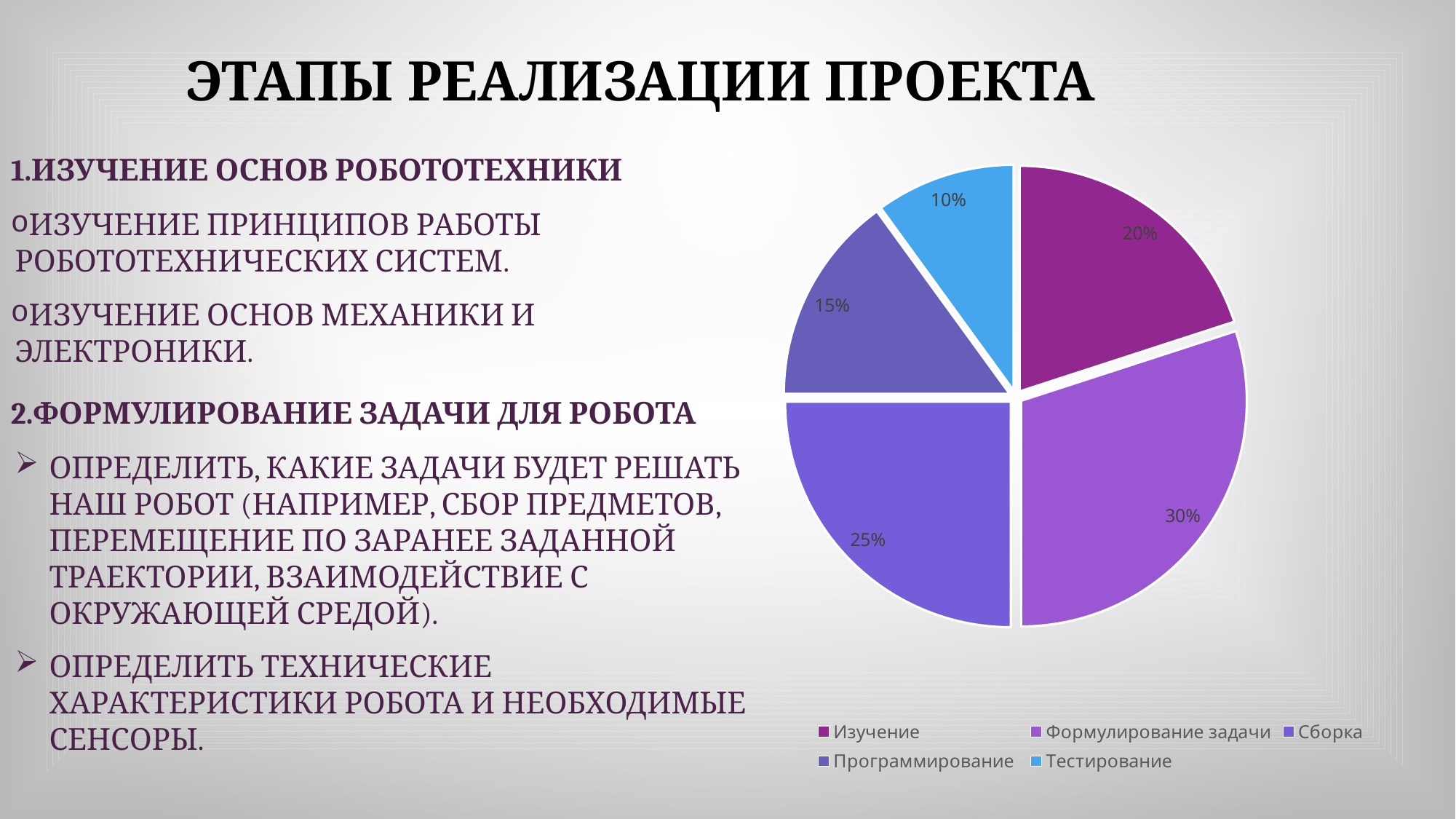
What share of the pie does Формулирование задачи have? 30% What is the difference between the shares of Формулирование задачи and Сборка? 5% Which category has the largest slice of the pie? Формулирование задачи How many entries does the legend list? 5 What share of the pie does Изучение have? 20% How many slices does the pie chart have? 5 Which is larger, the share of Изучение or the share of Программирование? Изучение Which category has the smallest slice of the pie? Тестирование What share of the pie does Тестирование have? 10% What share of the pie does Сборка have? 25% What kind of chart is shown on the slide? pie chart What share of the pie does Программирование have? 15%